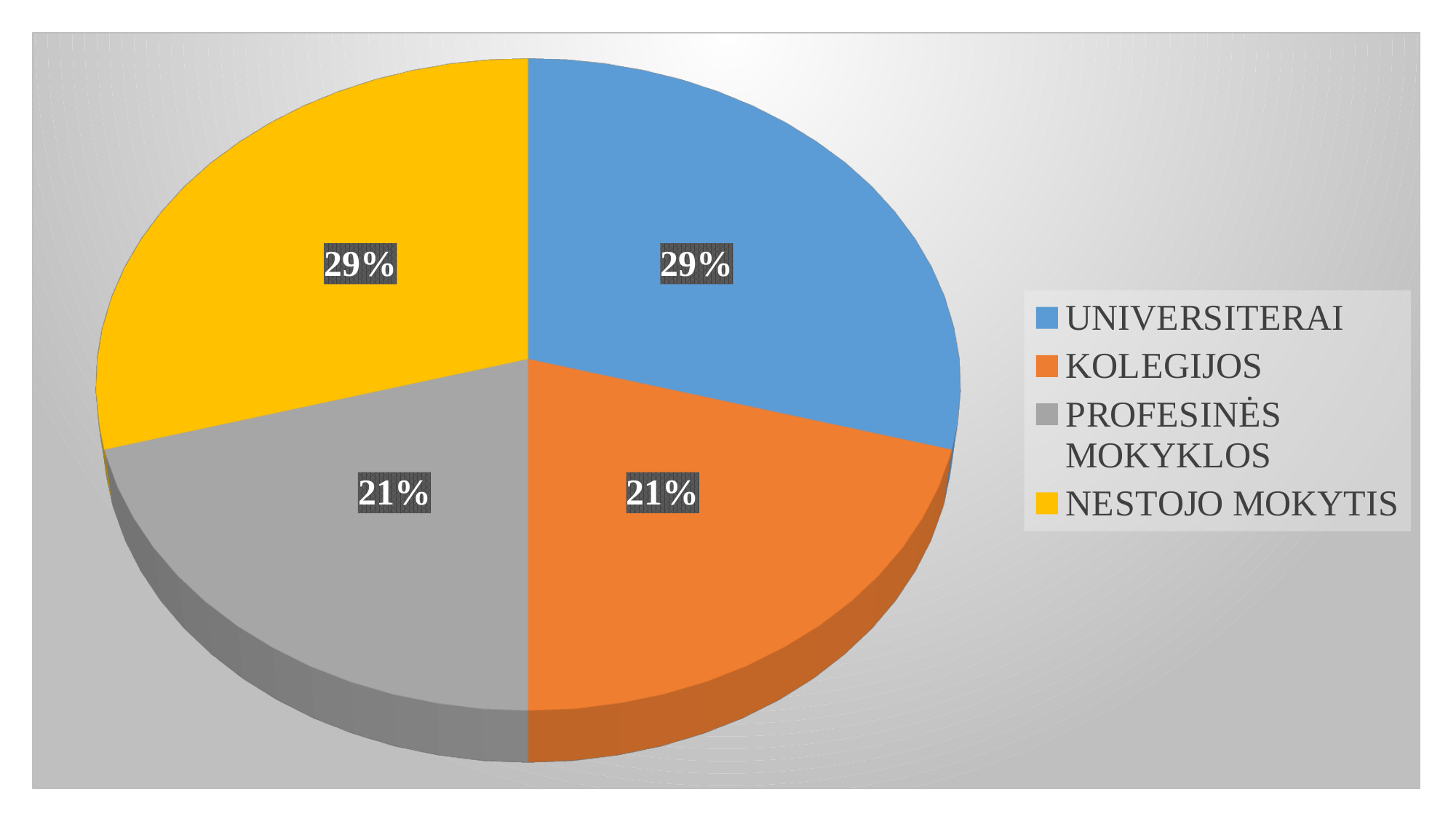
What is the difference in percentage points between the UNIVERSITERAI share and the PROFESINĖS MOKYKLOS share? 8 Which category is shown in blue in the chart? UNIVERSITERAI What share of the pie does KOLEGIJOS represent? 21% What is the value shown for PROFESINĖS MOKYKLOS? 21% What kind of chart is shown on the slide? Pie chart What share of the pie does UNIVERSITERAI represent? 29% Which colour represents NESTOJO MOKYTIS in the chart? Yellow How many categories does the pie chart show? 4 What is the difference in percentage points between the NESTOJO MOKYTIS share and the KOLEGIJOS share? 8 What is the value shown for NESTOJO MOKYTIS? 29% Which is larger, the share for UNIVERSITERAI or the share for KOLEGIJOS? UNIVERSITERAI Which is larger, the share for PROFESINĖS MOKYKLOS or the share for NESTOJO MOKYTIS? NESTOJO MOKYTIS